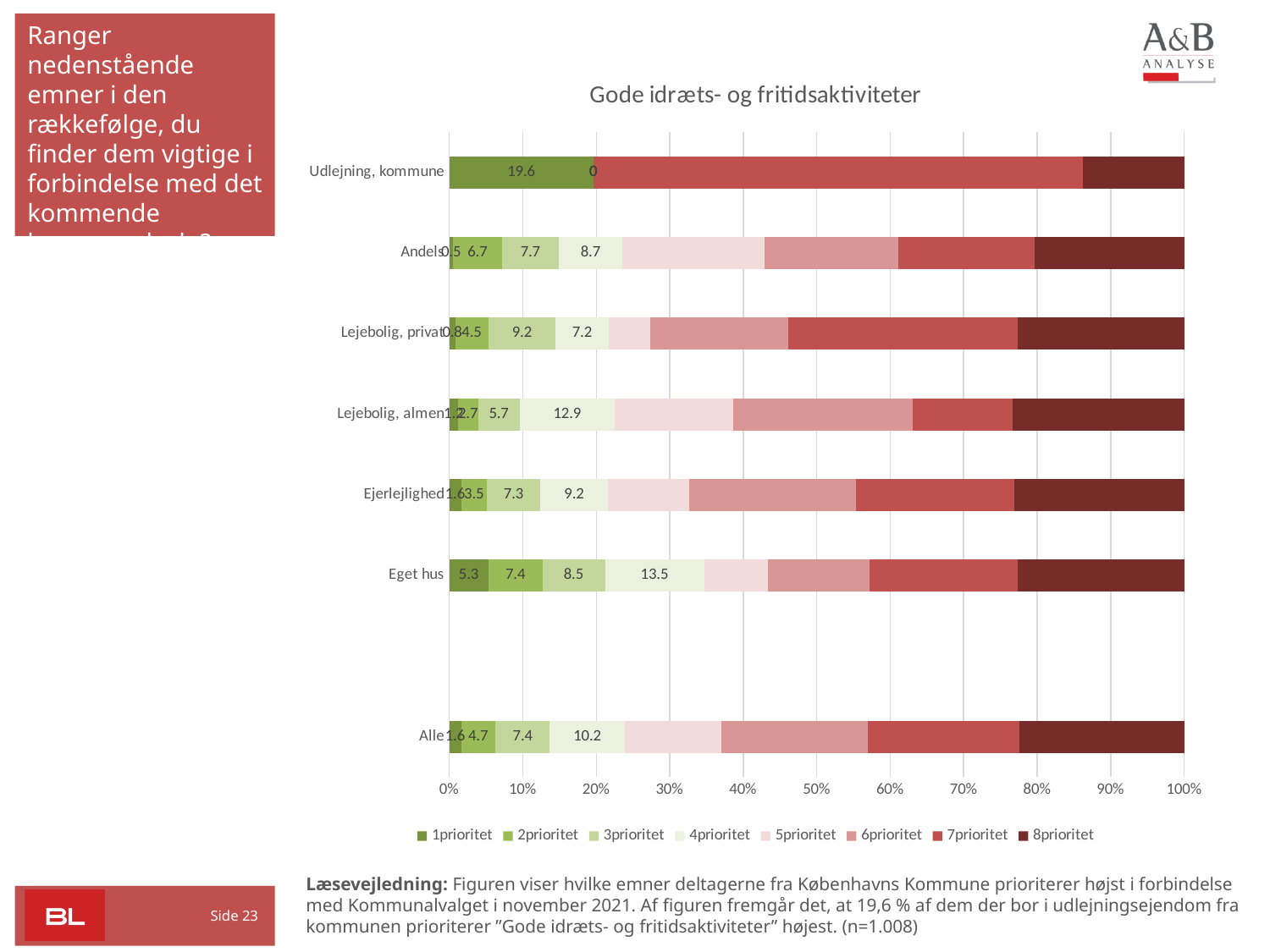
How many series does the legend list? 8 What is the 1prioritet value for Udlejning, kommune? 19.6 What is the 2prioritet value for Andels? 6.7 What is the title of the chart? Gode idræts- og fritidsaktiviteter What is the 3prioritet value for Alle? 7.4 What kind of chart is shown on the slide? bar chart What is the 4prioritet value for Eget hus? 13.5 What is the difference between the 4prioritet value for Eget hus and the 4prioritet value for Alle? 3.3 Which has the larger 4prioritet value, Lejebolig, almen or Ejerlejlighed? Lejebolig, almen What is the 1prioritet value for Eget hus? 5.3 Which category has the highest 1prioritet value? Udlejning, kommune How many categories are plotted on the y axis of the chart? 7